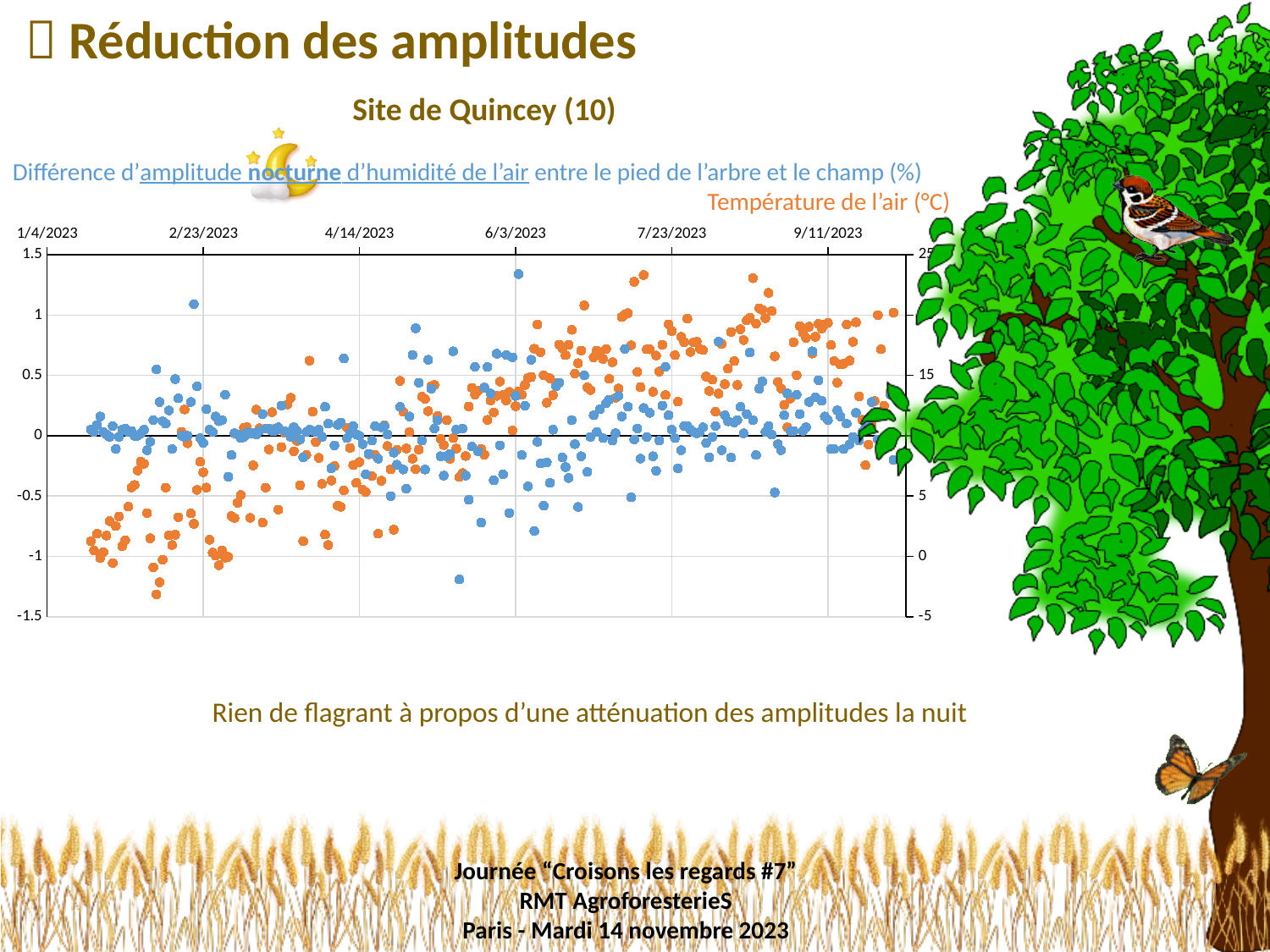
What is the last date label on the x axis of the chart? 9/11/2023 What kind of chart is shown on the slide? scatter chart How many date labels are shown on the x axis of the chart? 6 Are the orange air temperature values in August 2023 greater or less than 10 on the right-hand axis? greater What does the orange series on the chart represent? Température de l'air (°C) What is the first date label on the x axis of the chart? 1/4/2023 How many data series are plotted on the chart? 2 What is the minimum value shown on the left-hand y axis of the chart? -1.5 What is the maximum value shown on the right-hand y axis (temperature) of the chart? 25 Do the orange air temperature values rise or fall from January to September along the x axis? rise What does the blue series on the chart represent? Différence d'amplitude nocturne d'humidité de l'air entre le pied de l'arbre et le champ (%)